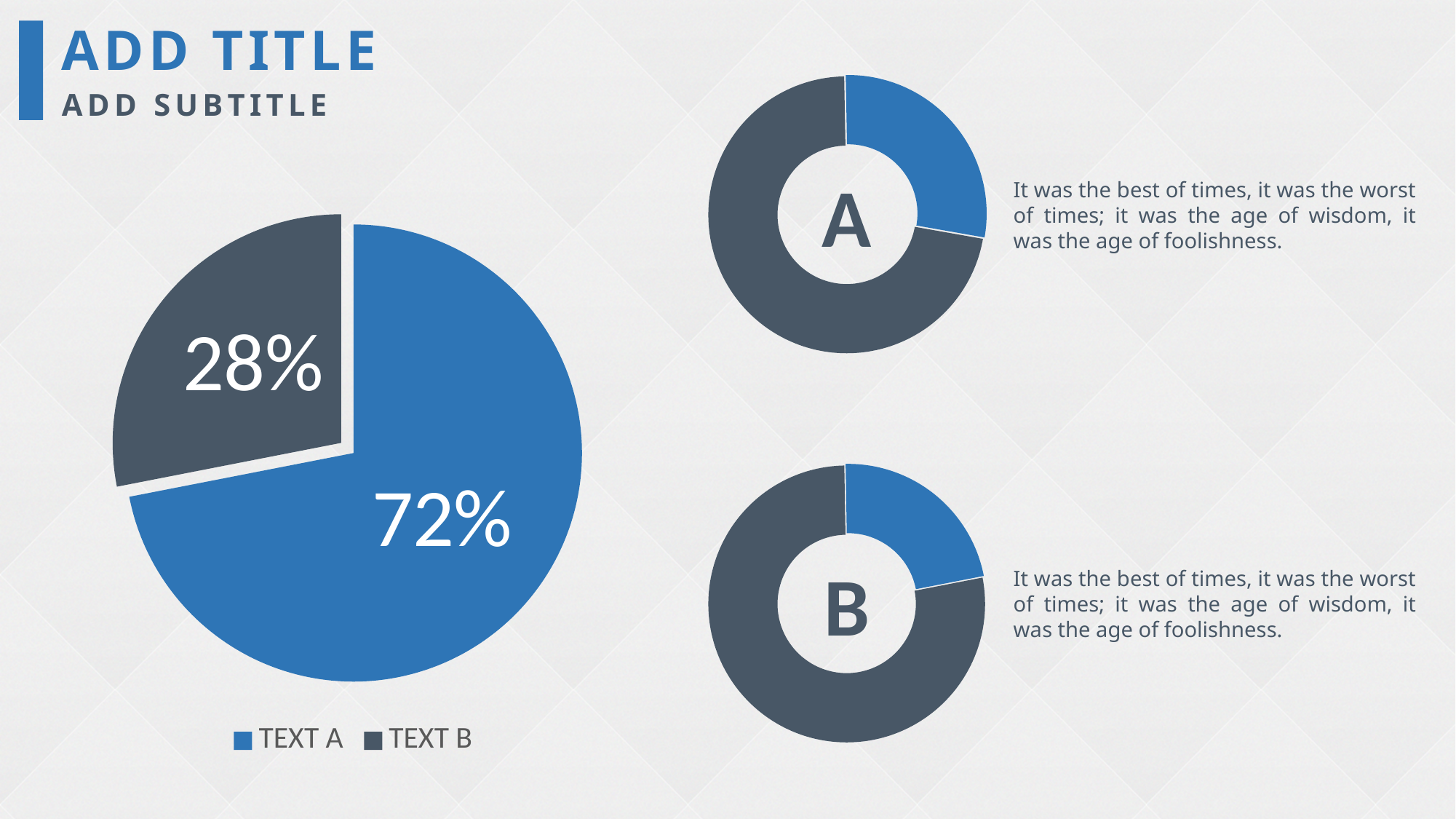
In the donut chart labeled A on the right, which segment is larger, the blue one or the dark gray one? The dark gray one In the pie chart on the left, what is the value for TEXT A? 72% In the pie chart on the left, how many slices are there? 2 In the pie chart on the left, which category has the largest share? TEXT A In the pie chart on the left, what is the value for TEXT B? 28% In the pie chart on the left, which category has the smallest share? TEXT B In the pie chart on the left, which is larger, TEXT A or TEXT B? TEXT A In the pie chart on the left, which colour represents TEXT A? Blue How many entries does the legend of the pie chart on the left list? 2 What kind of chart is the large chart on the left of the slide? Pie chart In the pie chart on the left, what share of the pie does TEXT B take? 28% In the pie chart on the left, what is the difference in percentage points between TEXT A and TEXT B? 44